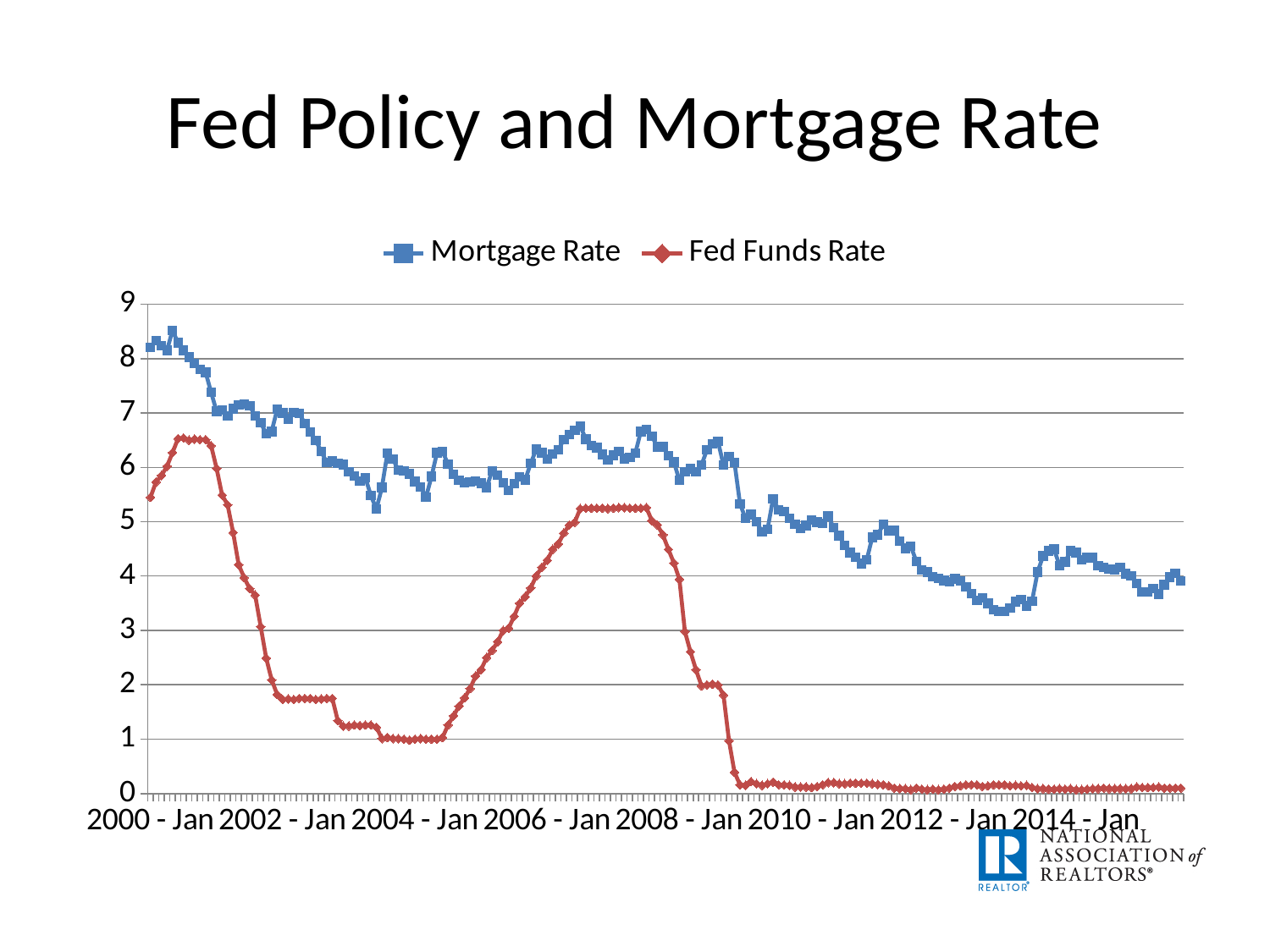
Is the Mortgage Rate at 2012 - Jan greater or less than 5? less What kind of chart is shown on the slide? line chart Is the Fed Funds Rate at 2010 - Jan greater or less than 1? less Which series stays higher than the other across the whole period shown? Mortgage Rate What is the title of the chart on the slide? Fed Policy and Mortgage Rate At 2010 - Jan, which is higher: the Mortgage Rate or the Fed Funds Rate? Mortgage Rate Which series is drawn in red with diamond markers? Fed Funds Rate Does the Fed Funds Rate rise or fall between 2004 - Jan and 2006 - Jan? rise Is the Mortgage Rate at 2000 - Jan greater or less than 8? greater Does the Mortgage Rate overall rise or fall from 2000 - Jan to 2014 - Jan? fall How many series does the legend list? 2